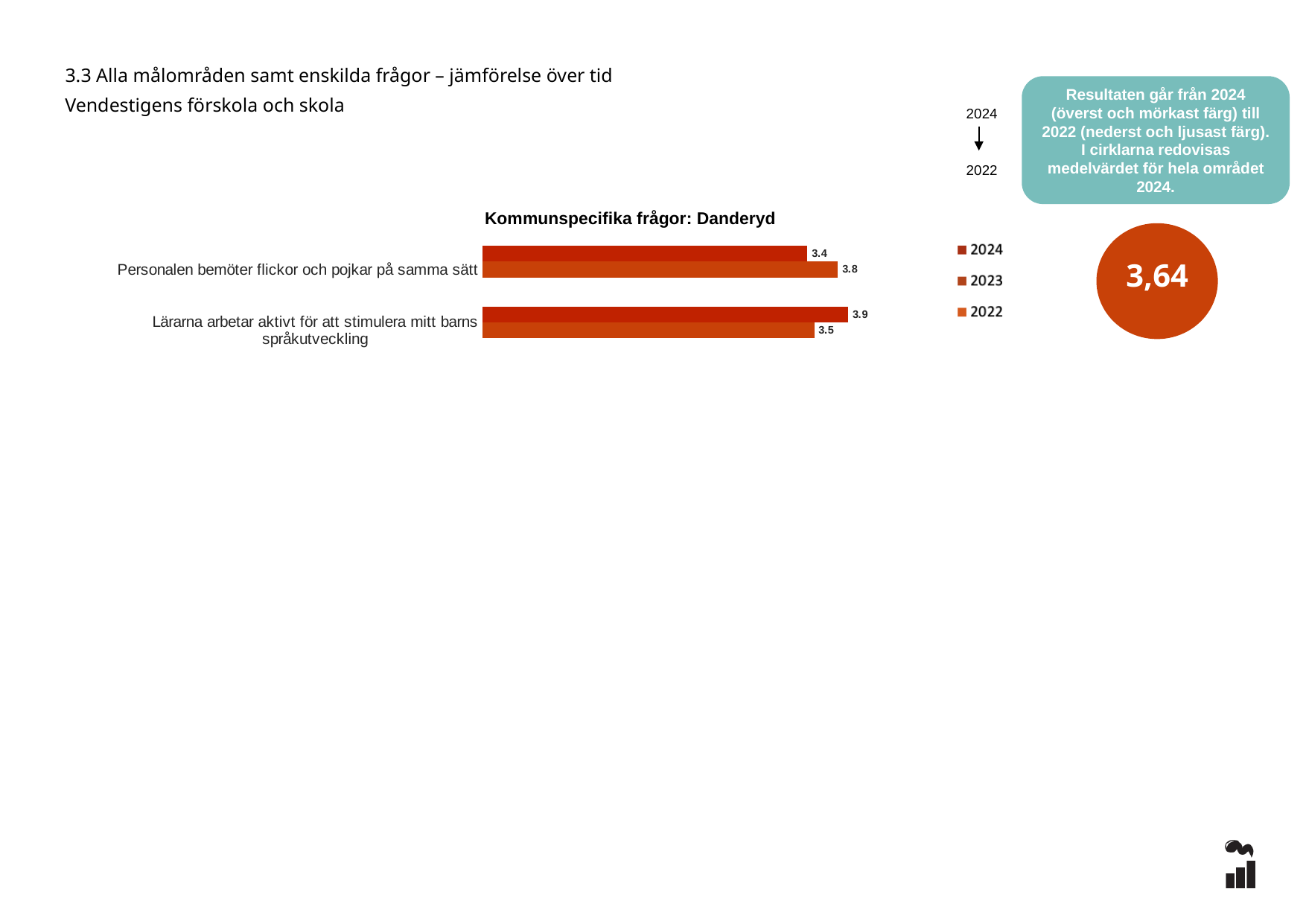
Which category has the higher 2024 value: "Personalen bemöter flickor och pojkar på samma sätt" or "Lärarna arbetar aktivt för att stimulera mitt barns språkutveckling"? Lärarna arbetar aktivt för att stimulera mitt barns språkutveckling What type of chart is shown on the slide? Bar chart How many series does the chart legend list? 3 For "Personalen bemöter flickor och pojkar på samma sätt", what is the difference between the lower bar (3.8) and the 2024 bar (3.4)? 0.4 What is the 2024 value (top, darkest bar) for "Personalen bemöter flickor och pojkar på samma sätt"? 3.4 What is the highest value printed on any bar in the chart? 3.9 How many categories (questions) are shown in the chart? 2 What is the title of the chart? Kommunspecifika frågor: Danderyd For "Lärarna arbetar aktivt för att stimulera mitt barns språkutveckling", what is the difference between the 2024 bar (3.9) and the lower bar (3.5)? 0.4 What value is printed on the lower, lighter bar for "Personalen bemöter flickor och pojkar på samma sätt"? 3.8 What value is printed on the lower, lighter bar for "Lärarna arbetar aktivt för att stimulera mitt barns språkutveckling"? 3.5 What is the 2024 value (top, darkest bar) for "Lärarna arbetar aktivt för att stimulera mitt barns språkutveckling"? 3.9